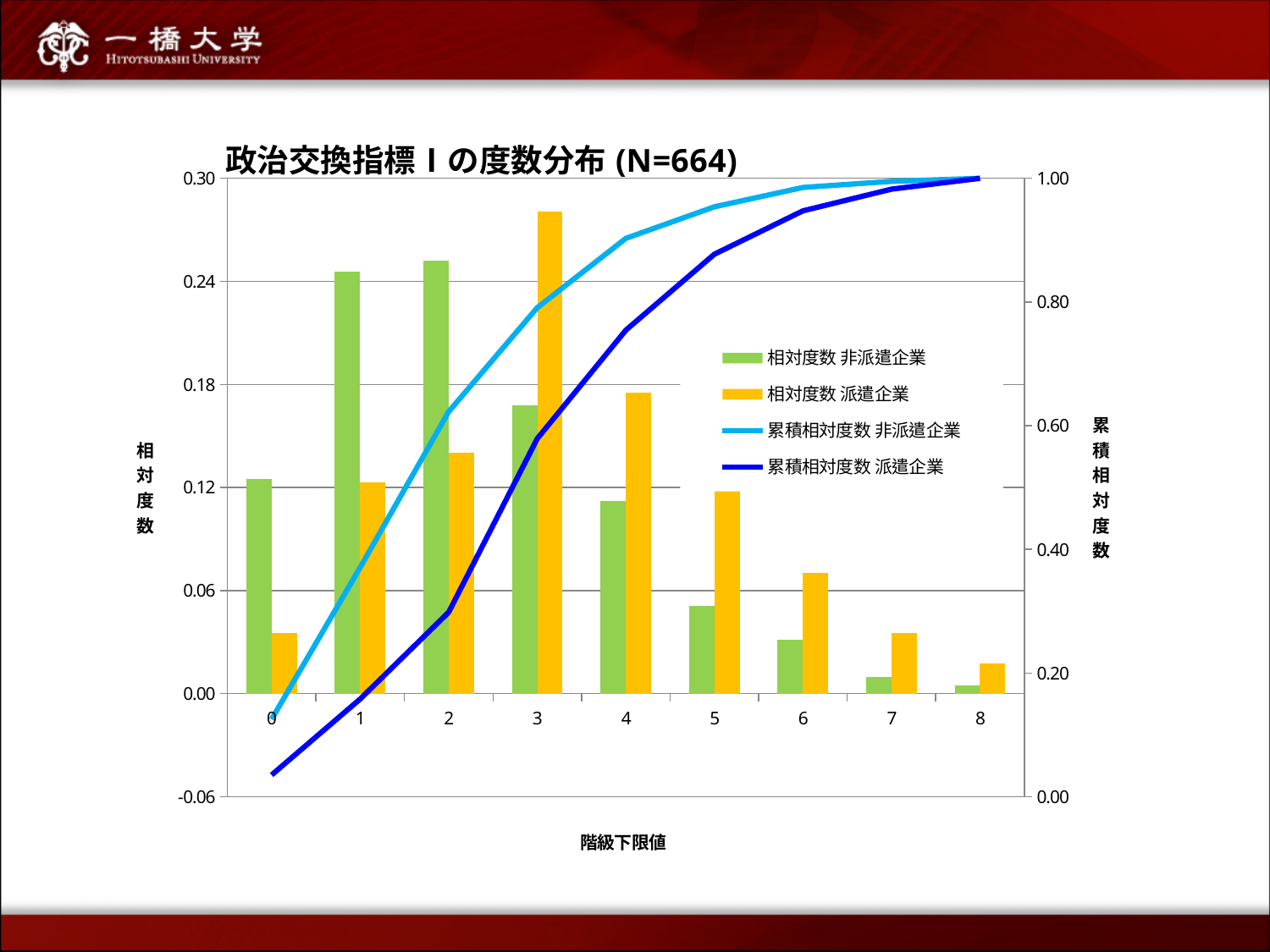
For the 相対度数 派遣企業 series, which 階級下限値 has the highest bar? 3 What kind of chart is this? Combination bar and line chart How many series does the legend list? 4 What is the title of the chart? 政治交換指標Ⅰの度数分布 (N=664) How many categories are shown on the x axis (階級下限値)? 9 At 階級下限値 1, which is larger: 相対度数 非派遣企業 or 相対度数 派遣企業? 相対度数 非派遣企業 At 階級下限値 3, which is larger: 相対度数 非派遣企業 or 相対度数 派遣企業? 相対度数 派遣企業 Is the 相対度数 派遣企業 value at 階級下限値 0 greater or less than 0.06? less Is the 相対度数 派遣企業 value at 階級下限値 3 greater or less than 0.24? greater For the 相対度数 非派遣企業 series, which 階級下限値 has the lowest bar? 8 Is the 相対度数 非派遣企業 value at 階級下限値 1 greater or less than 0.18? greater Do the 累積相対度数 lines rise or fall as 階級下限値 increases from 0 to 8? rise